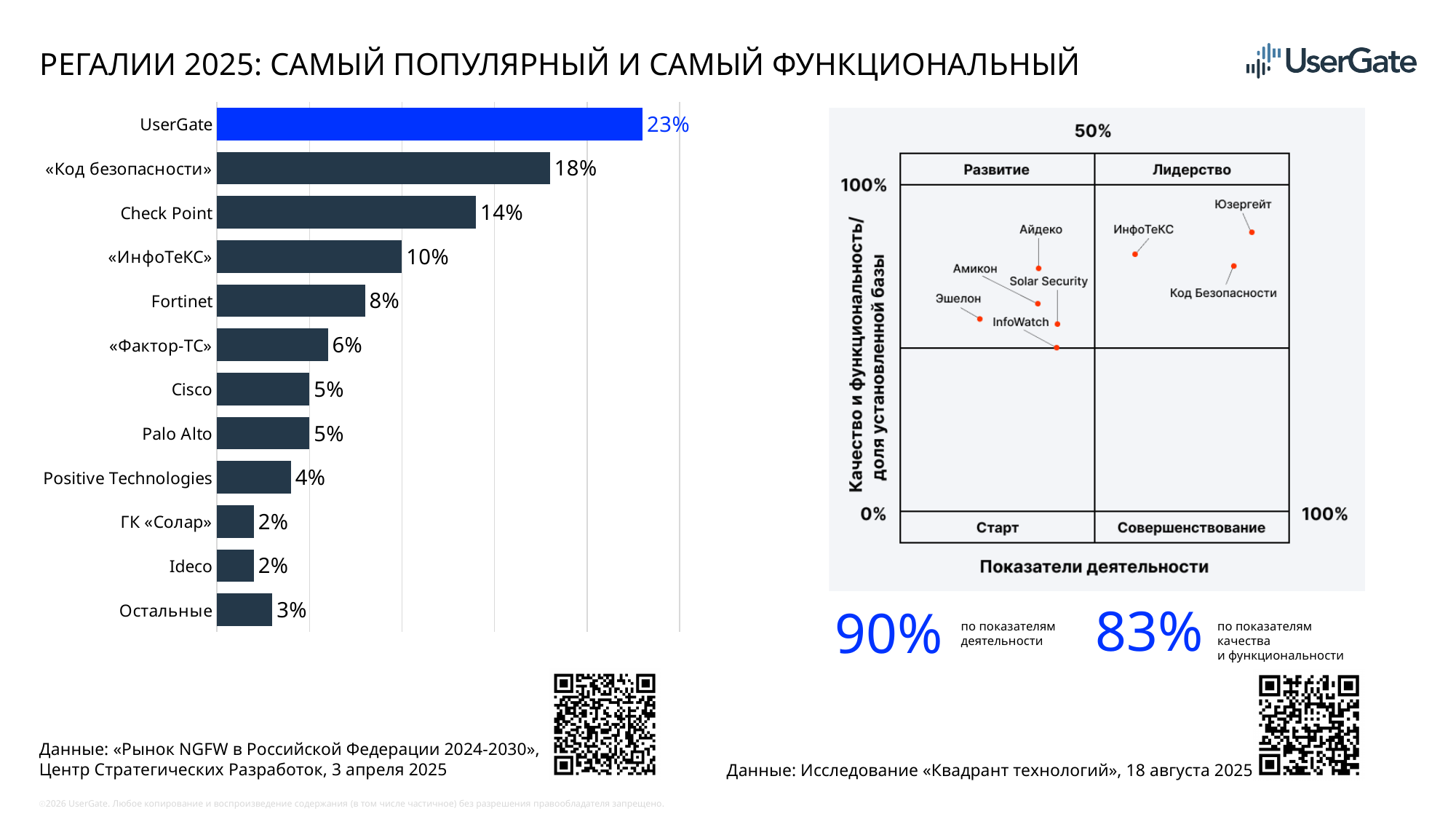
In the bar chart on the left, which category has the highest value? UserGate How many categories are shown in the bar chart on the left? 12 How many labelled points are plotted in the quadrant chart on the right? 8 In the bar chart on the left, which is larger: the value for «Фактор-ТС» or the value for Cisco? «Фактор-ТС» In the bar chart on the left, what is the value for Check Point? 14% In the bar chart on the left, what is the value for Fortinet? 8% In the bar chart on the left, what is the value for Positive Technologies? 4% In the bar chart on the left, what is the value for UserGate? 23% In the quadrant chart on the right, which quadrant contains the point labelled Юзергейт? Лидерство In the bar chart on the left, what is the difference between UserGate and «Код безопасности»? 5% What kind of chart is the chart on the left of the slide? Bar chart In the bar chart on the left, what is the difference between Check Point and «ИнфоТеКС»? 4%